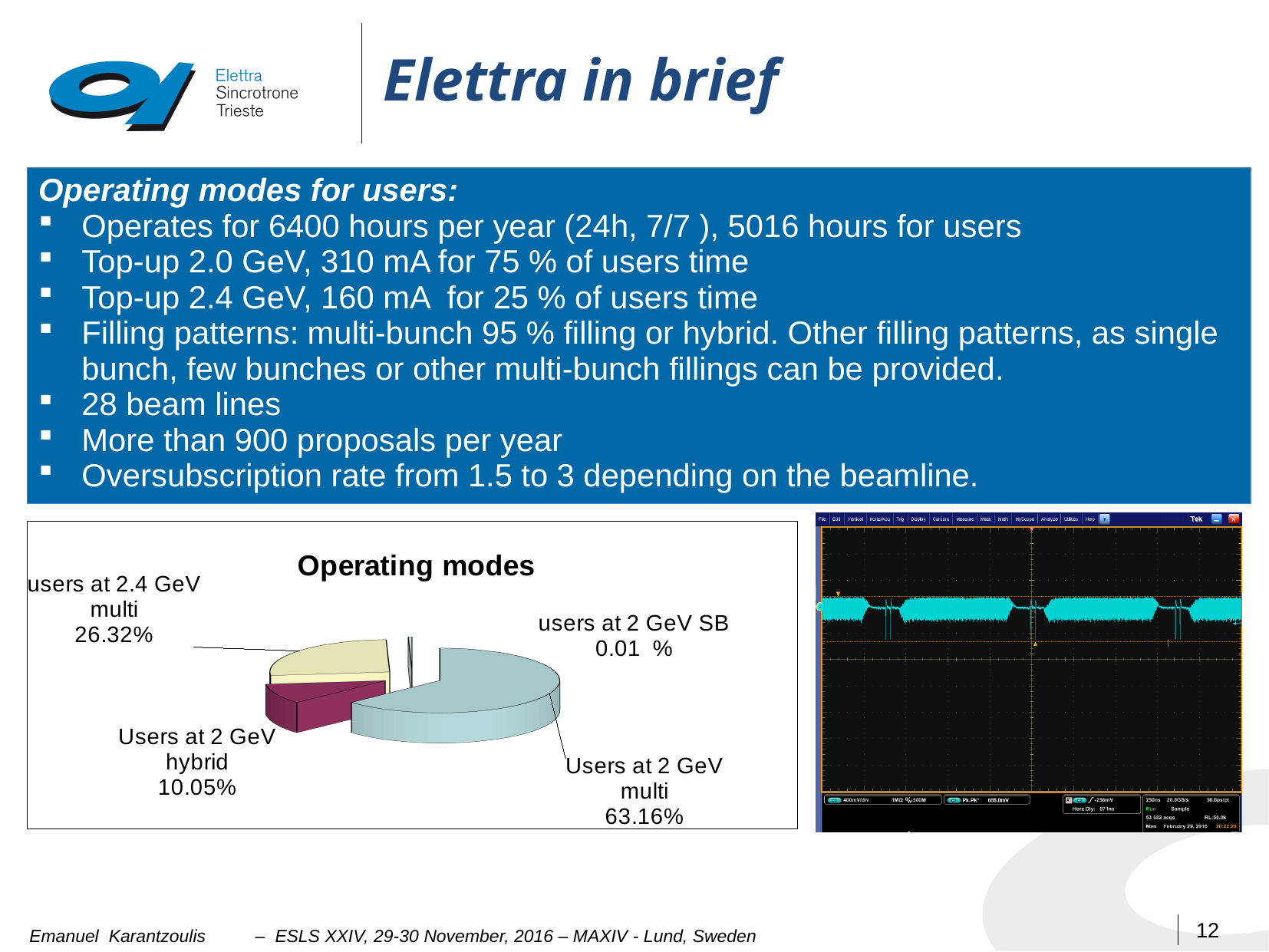
In the "Operating modes" pie chart, which operating mode has the largest share? Users at 2 GeV multi In the "Operating modes" pie chart, what share is labelled for users at 2.4 GeV multi? 26.32% In the "Operating modes" pie chart, what is the difference between the shares of Users at 2 GeV multi and users at 2.4 GeV multi? 36.84% In the "Operating modes" pie chart, which operating mode has the smallest share? users at 2 GeV SB What is the title of the pie chart on the slide? Operating modes In the "Operating modes" pie chart, what is the difference between the shares of users at 2.4 GeV multi and Users at 2 GeV hybrid? 16.27% In the "Operating modes" pie chart, how many slices are there? 4 What kind of chart is the "Operating modes" chart? pie chart In the "Operating modes" pie chart, what share is labelled for Users at 2 GeV multi? 63.16% In the "Operating modes" pie chart, what share is labelled for users at 2 GeV SB? 0.01 % In the "Operating modes" pie chart, which is larger: the share of Users at 2 GeV hybrid or the share of users at 2.4 GeV multi? users at 2.4 GeV multi In the "Operating modes" pie chart, what share is labelled for Users at 2 GeV hybrid? 10.05%